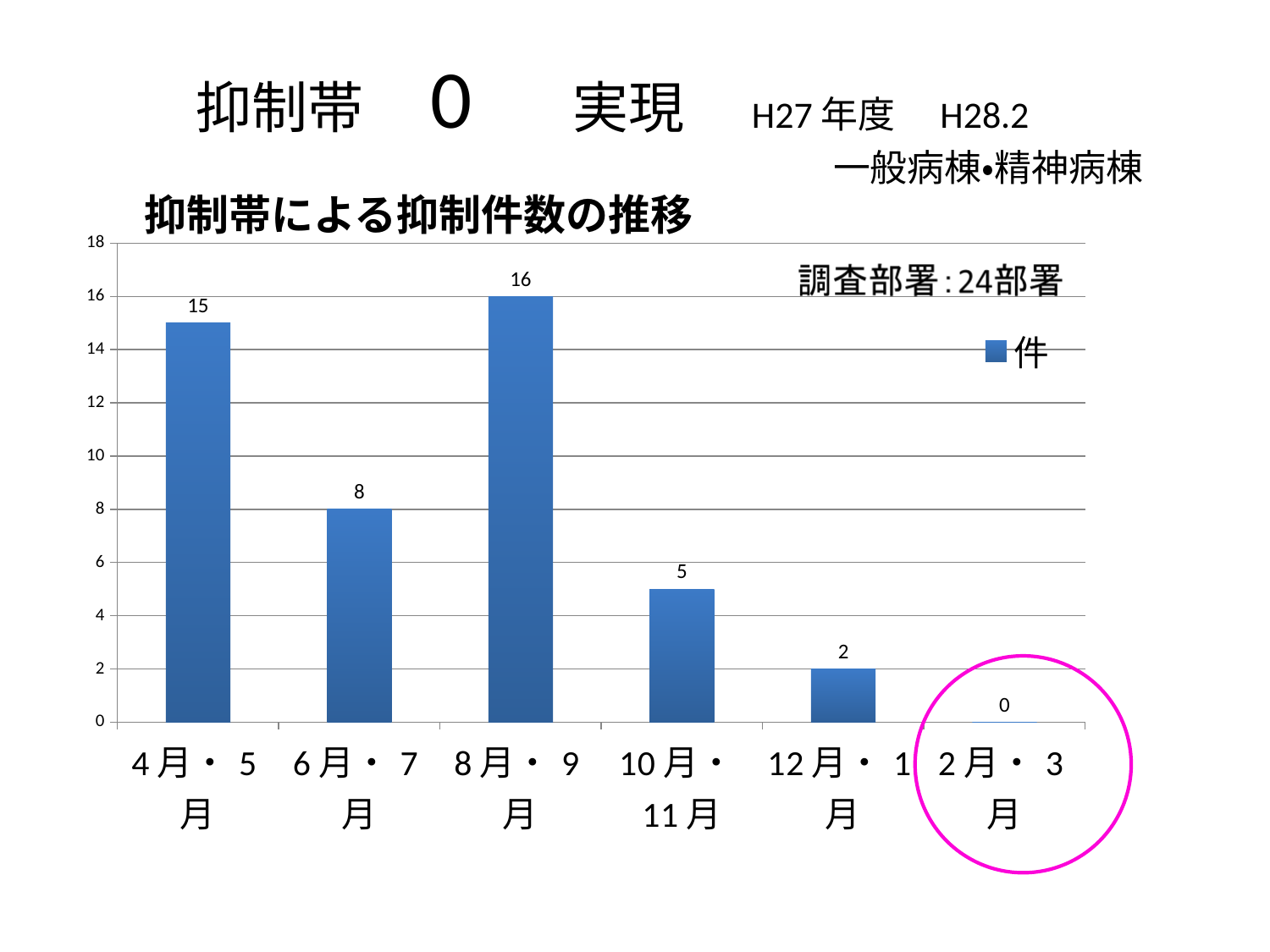
How many series does the legend list? 1 What is the value for 8月・9月? 16 What is the difference between the values for 8月・9月 and 6月・7月? 8 What is the title of the chart? 抑制帯による抑制件数の推移 Which is larger, the value for 6月・7月 or the value for 10月・11月? 6月・7月 What is the value for 2月・3月? 0 Which period has the highest value? 8月・9月 How many periods are shown on the x axis? 6 What is the value for 4月・5月? 15 Which period has the lowest value? 2月・3月 What kind of chart is shown? bar chart What is the value for 12月・1月? 2